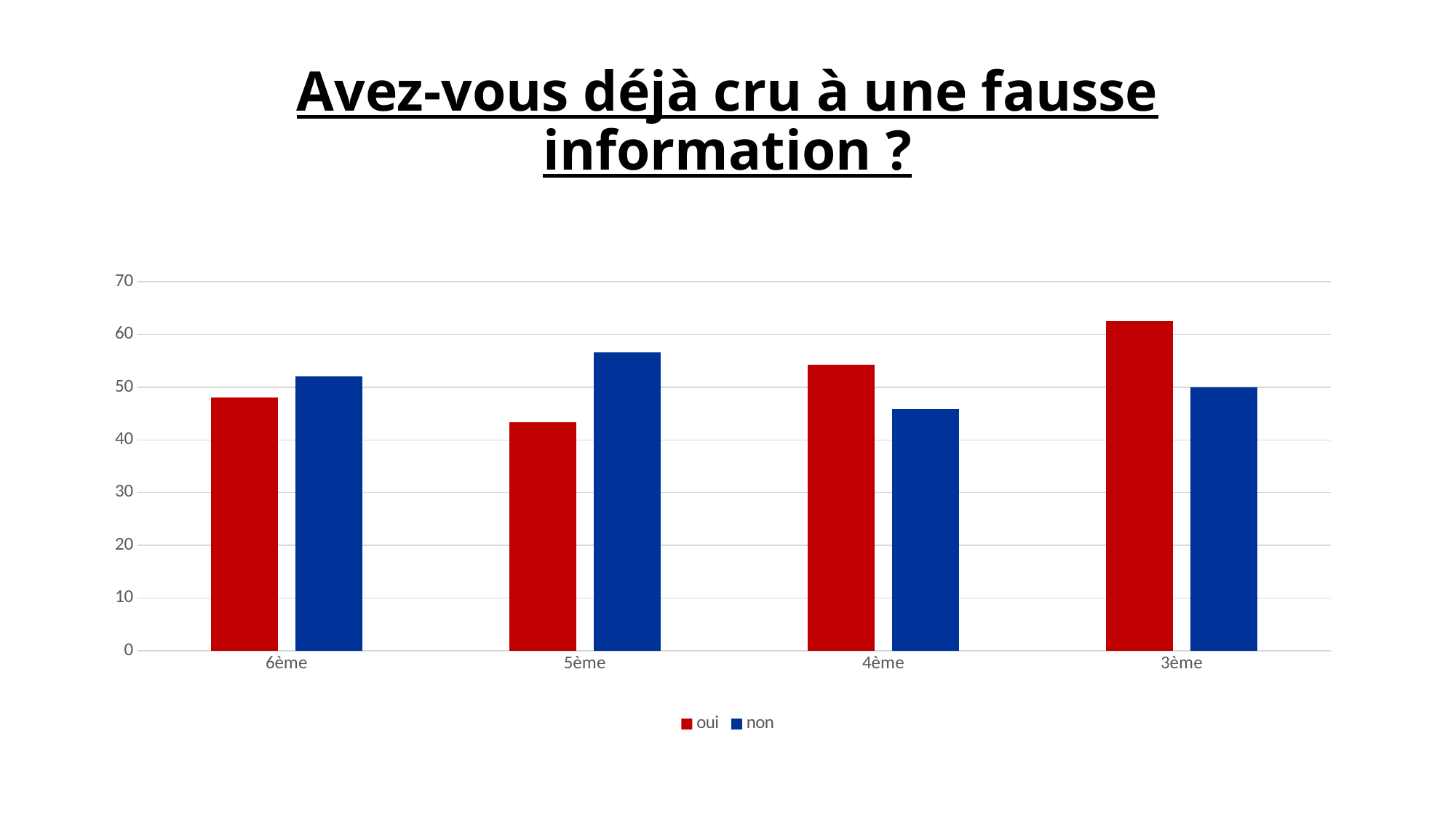
How many categories (class levels) are shown on the x axis? 4 For 5ème, which is larger: 'oui' or 'non'? non Which category has the highest value for the 'oui' series? 3ème For 4ème, which is larger: 'oui' or 'non'? oui How many series does the legend list? 2 What kind of chart is shown on the slide? bar chart Is the 'oui' value for 3ème greater or less than 60? greater Is the 'non' value for 4ème greater or less than 50? less Is the 'oui' value for 5ème greater or less than 50? less What colour represents the 'non' series in the chart? blue Which category has the highest value for the 'non' series? 5ème Which category has the lowest value for the 'oui' series? 5ème